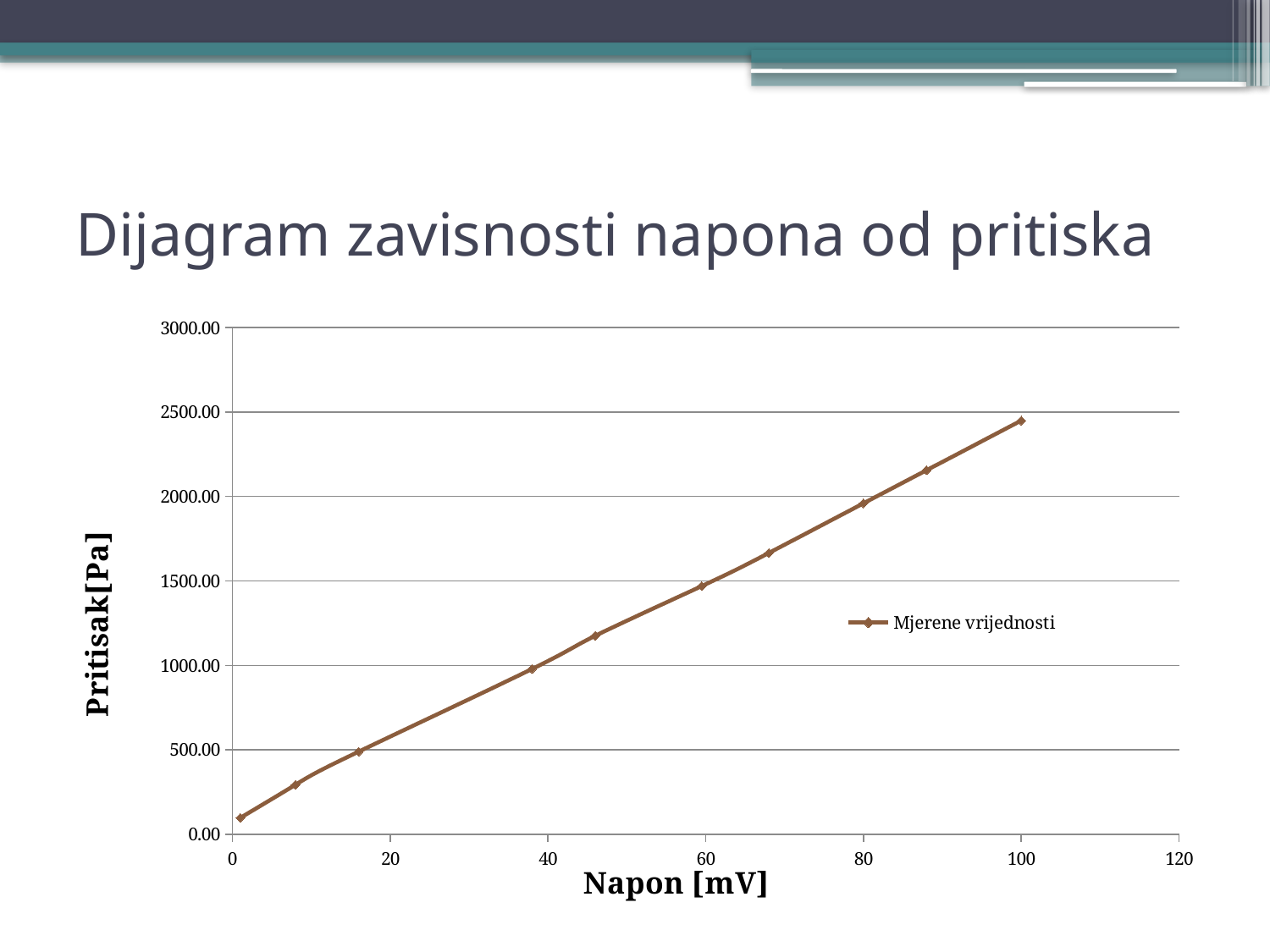
How many series does the legend list? 1 Is the pressure value at 40 mV greater or less than 1500.00 Pa? less Is the pressure value at 100 mV greater or less than 2500.00 Pa? less What kind of chart is shown on the slide? line chart What is the label of the y axis? Pritisak[Pa] Do the plotted values rise or fall as the voltage (Napon) increases along the x axis? rise How many data points are plotted on the line? 10 What is the name of the series shown in the legend? Mjerene vrijednosti Is the pressure value at 100 mV greater or less than 2000.00 Pa? greater Which plotted point has the highest pressure value: the one at 100 mV or the one at 80 mV? 100 mV